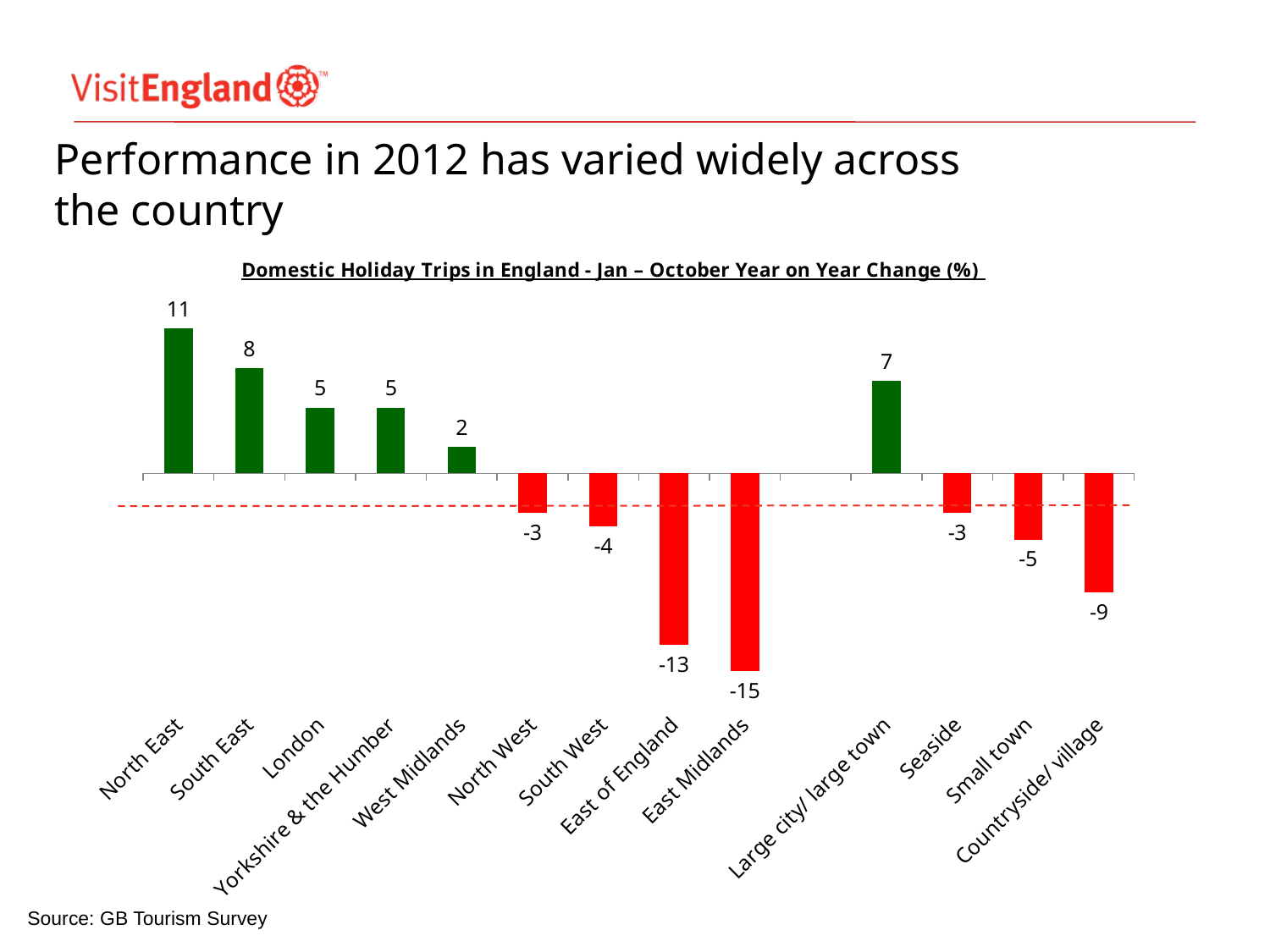
What is the value shown for Large city/ large town? 7 What is the difference between the values for North East and South East? 3 Which category has the highest year-on-year change? North East What is the year-on-year change for North East? 11 What type of chart is shown on the slide? Bar chart Which category has the lowest year-on-year change? East Midlands What is the year-on-year change for East Midlands? -15 Which has a larger value, South East or Large city/ large town? South East Which has a larger value, Seaside or Small town? Seaside What is the value shown for Countryside/ village? -9 What is the difference between the values for East of England and East Midlands? 2 How many labelled categories are shown on the x axis? 13